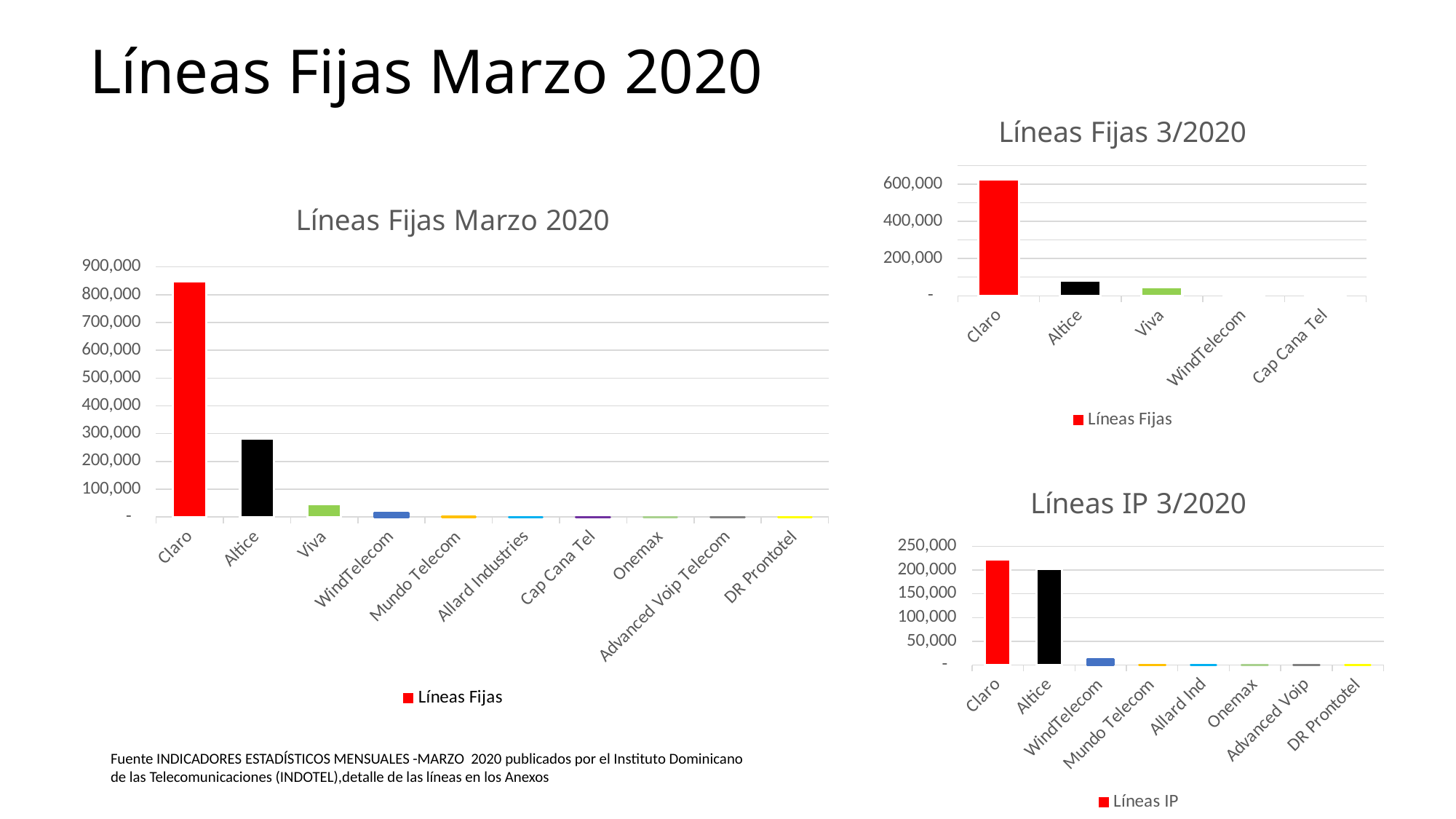
In the chart titled 'Líneas IP 3/2020', which category has the highest value? Claro In the chart titled 'Líneas Fijas Marzo 2020', how many categories are shown on the x axis? 10 In the chart titled 'Líneas Fijas Marzo 2020', which is larger, the value for Altice or the value for Viva? Altice In the chart titled 'Líneas Fijas 3/2020', is the value for Altice greater or less than 200,000? less What type of chart is the chart titled 'Líneas IP 3/2020'? bar chart In the chart titled 'Líneas Fijas Marzo 2020', is the value for Viva greater or less than 100,000? less In the chart titled 'Líneas Fijas 3/2020', how many categories are shown on the x axis? 5 In the chart titled 'Líneas IP 3/2020', how many categories are shown on the x axis? 8 In the chart titled 'Líneas Fijas Marzo 2020', is the value for Altice greater or less than 200,000? greater In the chart titled 'Líneas Fijas Marzo 2020', which category has the highest value? Claro